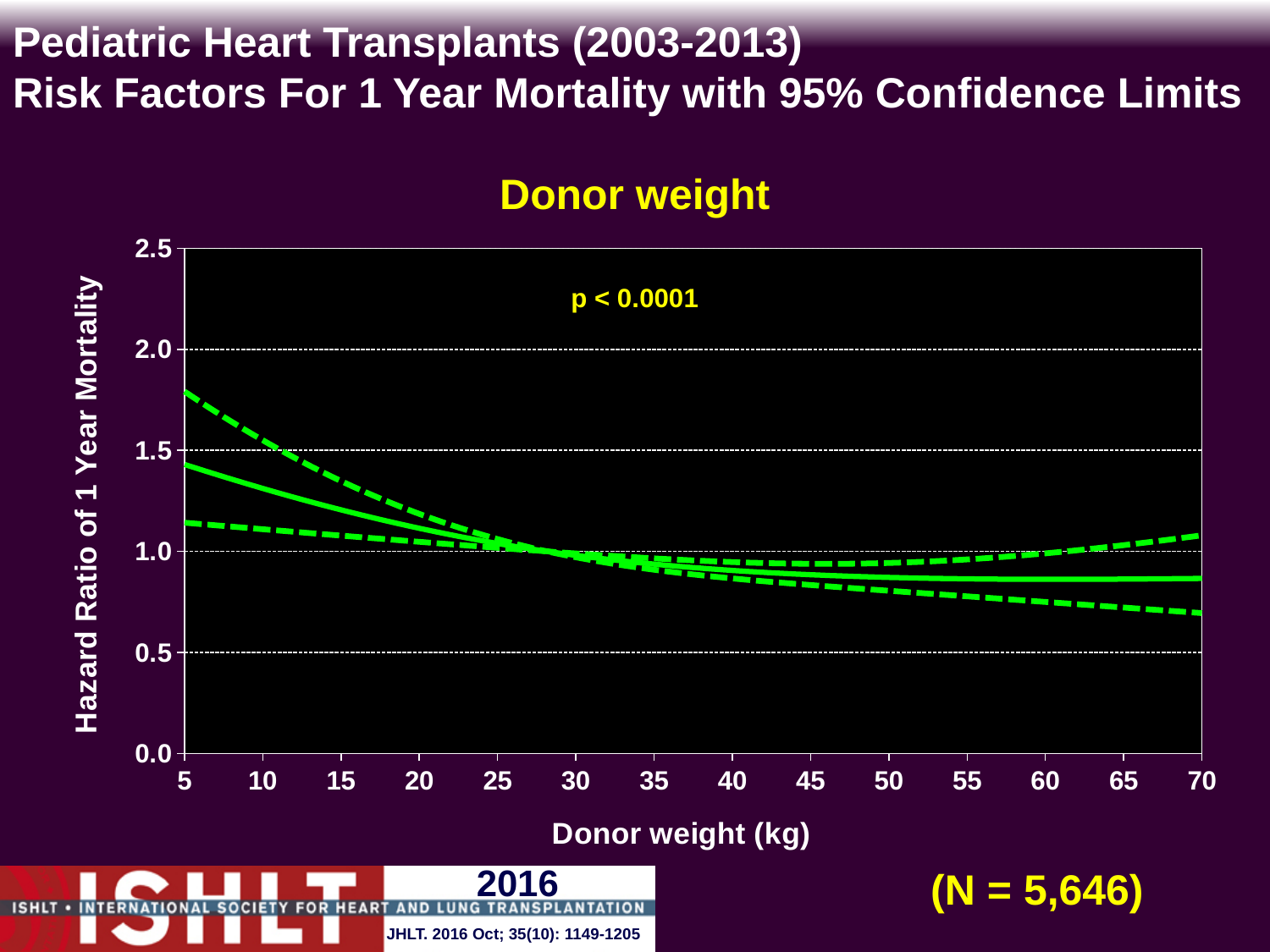
Is the hazard ratio on the solid line at a donor weight of 70 kg greater or less than 1.0? less How many lines are plotted on the chart? 3 Does the solid hazard ratio line rise or fall as donor weight increases from 5 kg to 70 kg? fall Is the upper dashed confidence limit at a donor weight of 5 kg greater or less than 1.5? greater What is the label of the y axis? Hazard Ratio of 1 Year Mortality Is the hazard ratio on the solid line higher at a donor weight of 5 kg or at 70 kg? 5 kg Is the hazard ratio on the solid line at a donor weight of 5 kg greater or less than 2.0? less How many tick labels are shown on the x axis? 14 What kind of chart is shown on the slide? line chart What is the title of the chart? Donor weight